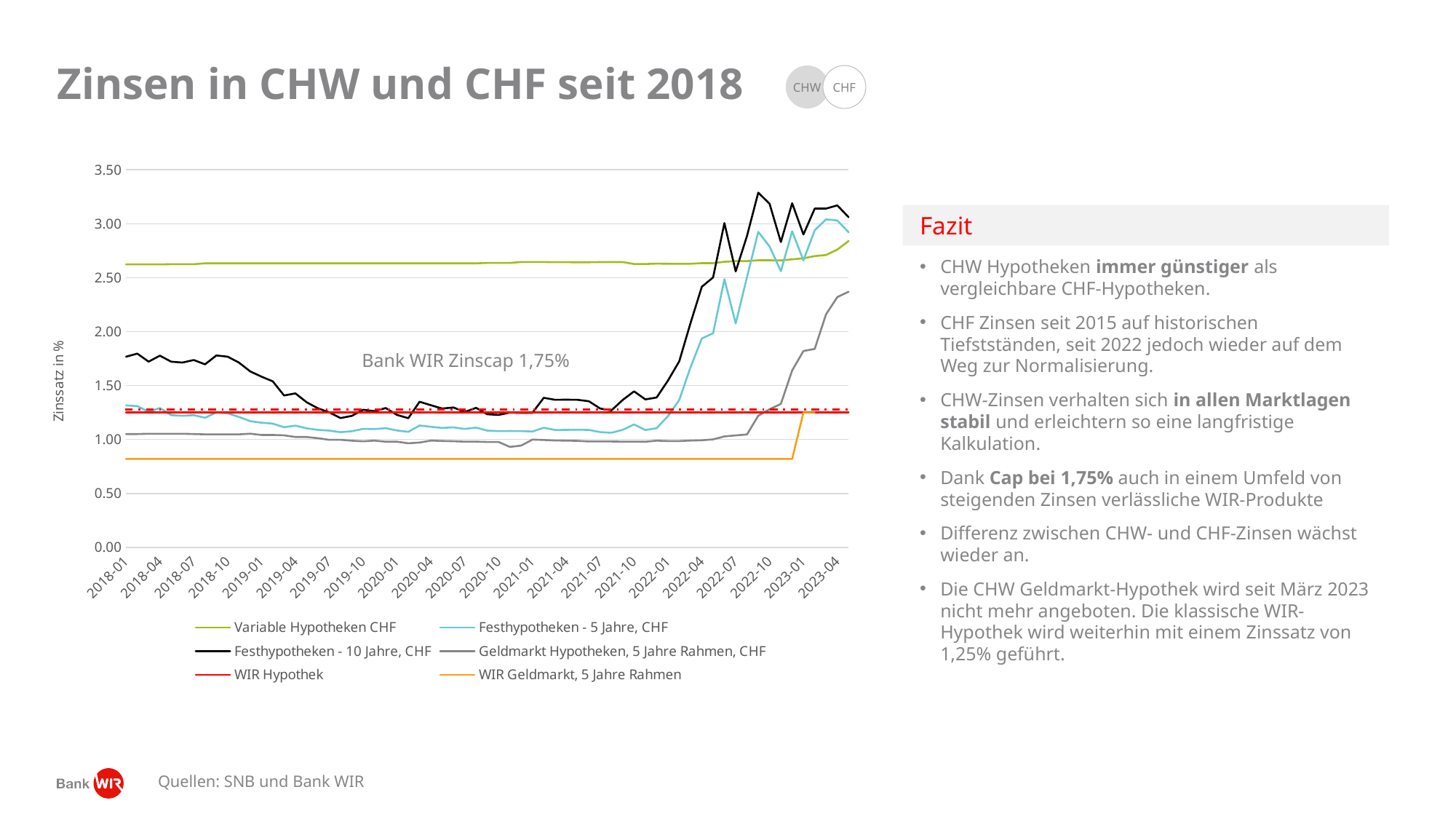
Is the value for Geldmarkt Hypotheken, 5 Jahre Rahmen, CHF at 2023-04 greater or less than 2.00? greater Is the value for WIR Geldmarkt, 5 Jahre Rahmen at 2018-01 greater or less than 1.00? less What value does the annotation inside the chart give for the Bank WIR Zinscap? 1,75% Which series has the highest value at 2023-04? Festhypotheken - 10 Jahre, CHF Is the value for Variable Hypotheken CHF at 2018-01 greater or less than 2.50? greater How many series does the chart legend list? 6 Does the Festhypotheken - 10 Jahre, CHF line rise or fall between 2022-01 and 2023-04? rise What kind of chart is shown on the slide? line chart At 2018-01, which is higher: Variable Hypotheken CHF or Festhypotheken - 10 Jahre, CHF? Variable Hypotheken CHF Which series has the lowest value at 2018-01? WIR Geldmarkt, 5 Jahre Rahmen What is the label of the vertical axis of the chart? Zinssatz in %